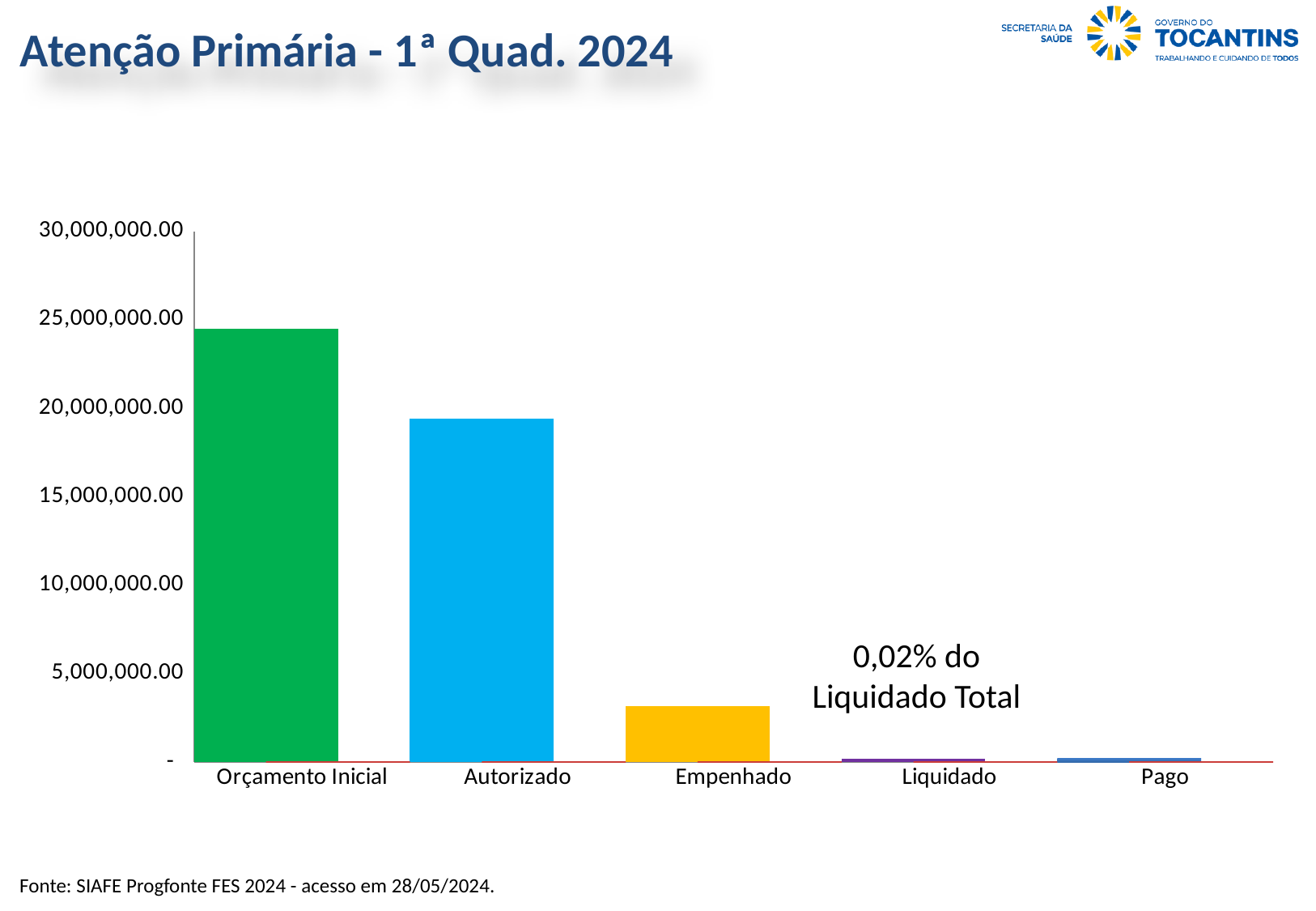
What percentage annotation is written above the Liquidado bar? 0,02% do Liquidado Total Which is larger, the value for Autorizado or the value for Empenhado? Autorizado Is the value for Orçamento Inicial greater or less than 20,000,000.00? greater Which category has the highest value in the chart? Orçamento Inicial Which is larger, the value for Orçamento Inicial or the value for Autorizado? Orçamento Inicial Is the value for Autorizado greater or less than 15,000,000.00? greater How many categories are shown on the x axis of the chart? 5 Do the values generally rise or fall from left to right along the x axis? fall Is the value for Empenhado greater or less than 5,000,000.00? less What is the title of the slide containing the chart? Atenção Primária - 1ª Quad. 2024 What kind of chart is shown on the slide? bar chart